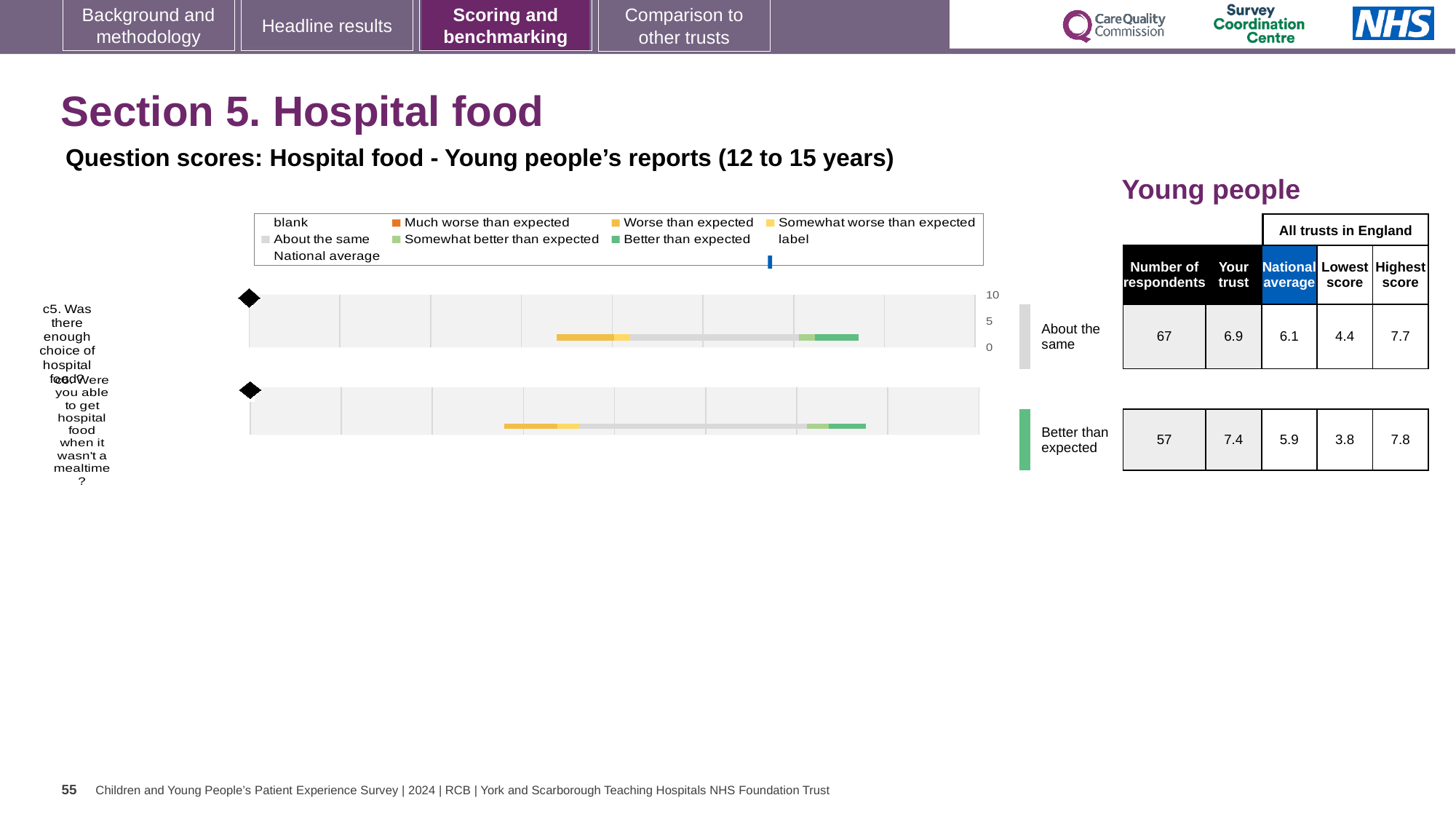
How many respondents answered question c5? 67 Which legend entry is shown in dark green? Better than expected What is the difference between the highest score and the lowest score for question c5? 3.3 Which benchmark category is shown for question c5 (Was there enough choice of hospital food?)? About the same What is the maximum value shown on the chart's axis? 10 How many survey questions are plotted in the hospital food chart? 2 Which question has the higher 'Your trust' score, c5 or c6? c6 What is the national average score for question c6? 5.9 What is the 'Your trust' score for question c6 (hospital food when it wasn't a mealtime)? 7.4 Which benchmark category is shown for question c6 (Were you able to get hospital food when it wasn't a mealtime?)? Better than expected What kind of chart is used to show the question scores for hospital food? bar chart What is the 'Your trust' score for question c5 (enough choice of hospital food)? 6.9